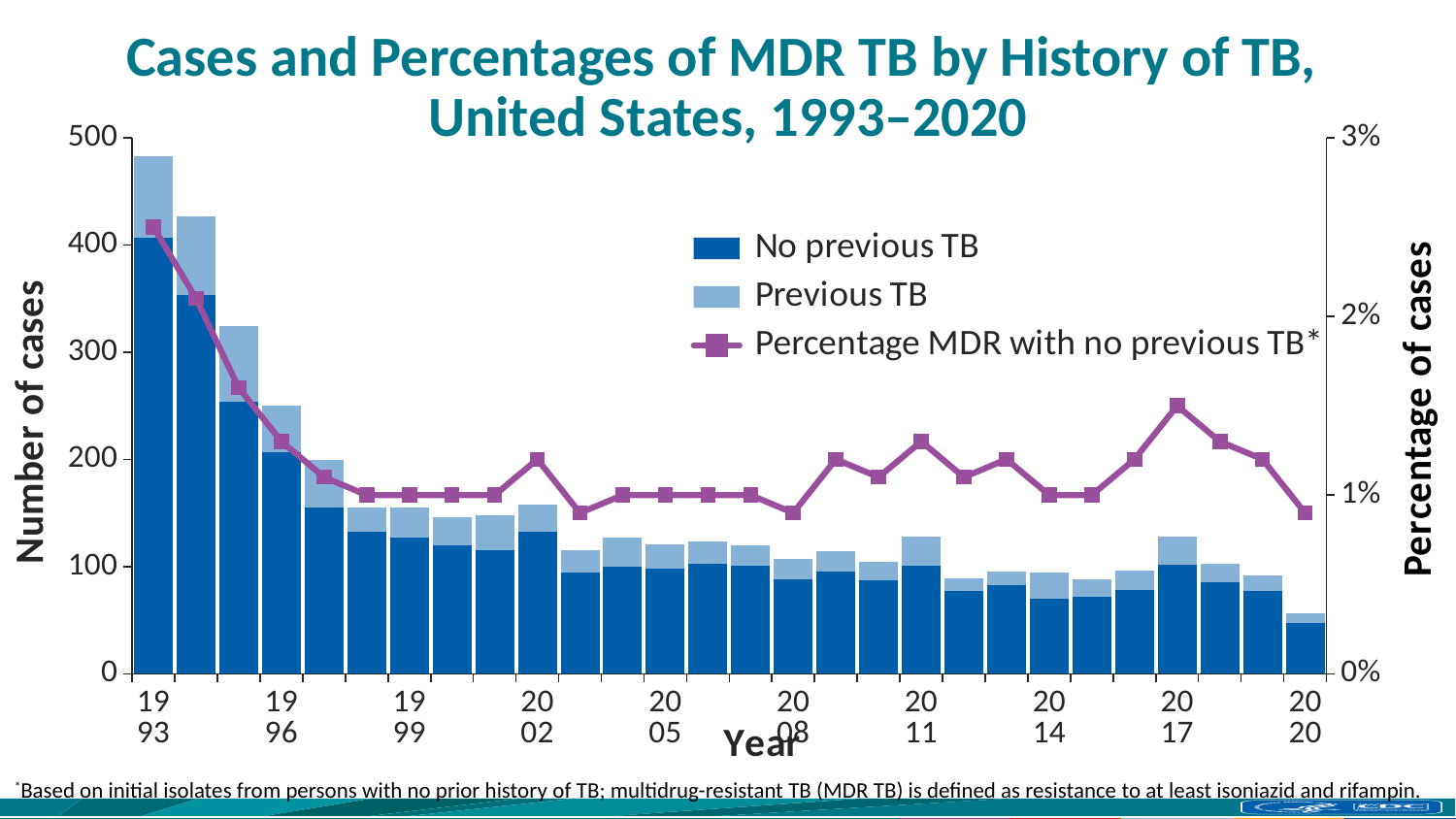
Which year has the highest total number of MDR TB cases? 1993 What kind of chart is this? Combination bar and line chart Which year has more total MDR TB cases, 1993 or 2020? 1993 Is the number of 'No previous TB' cases in 1993 greater or less than 400? greater In which year is the percentage of MDR with no previous TB highest? 1993 Is the percentage of MDR with no previous TB in 2017 greater or less than 1%? greater Which year has the lowest total number of MDR TB cases? 2020 Is the percentage of MDR with no previous TB in 1993 greater or less than 2%? greater Overall, does the total number of MDR TB cases rise or fall from 1993 to 2020? fall What is the title of the chart? Cases and Percentages of MDR TB by History of TB, United States, 1993–2020 How many entries does the chart legend list? 3